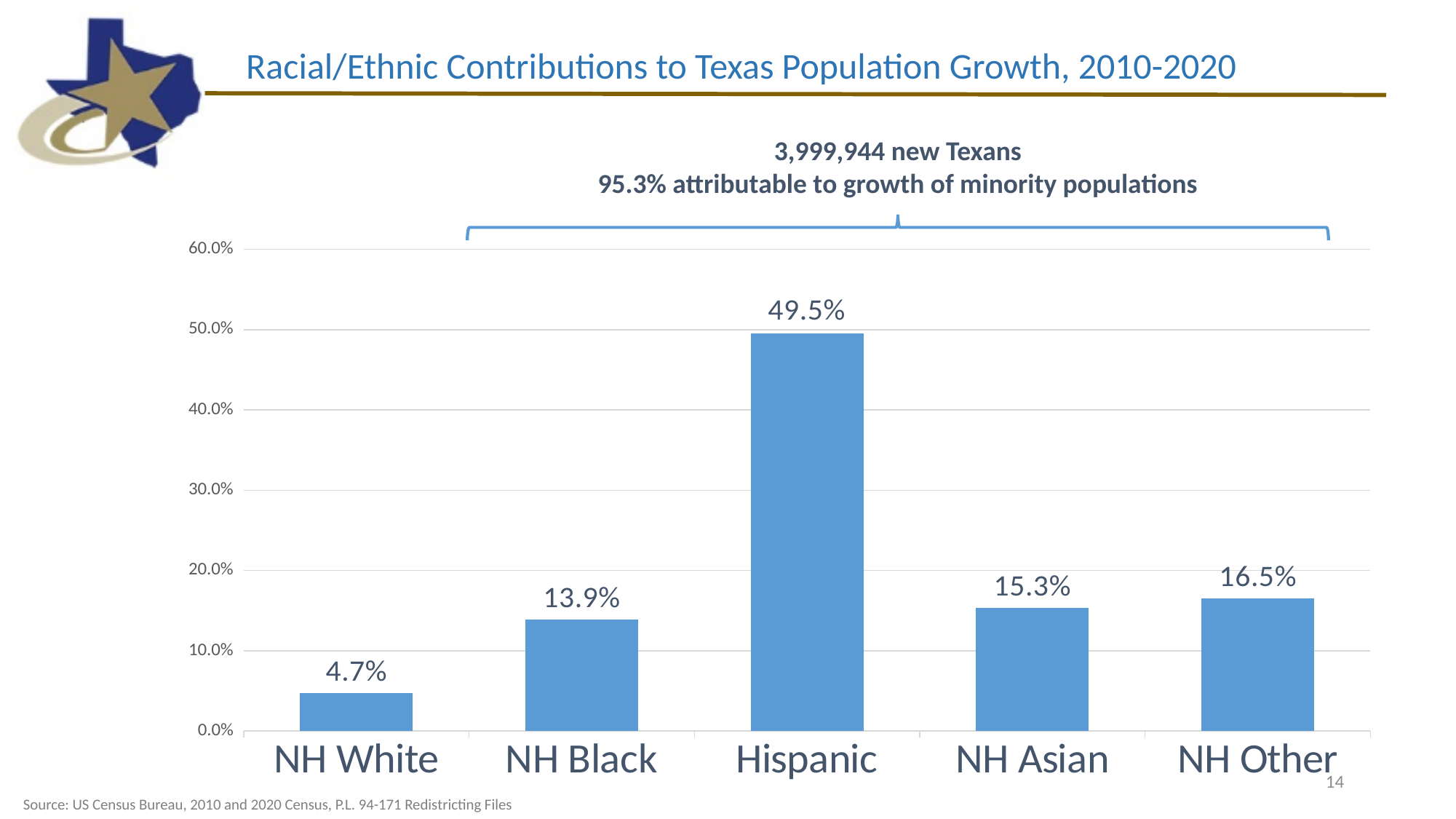
What is the title of the chart? Racial/Ethnic Contributions to Texas Population Growth, 2010-2020 Is the value for Hispanic greater or less than 40.0%? greater How many categories are shown on the x axis? 5 What is the difference between the values for NH Other and NH White? 11.8% What is the difference between the values for Hispanic and NH Black? 35.6% What is the value for NH Asian? 15.3% Which category has the lowest value? NH White What is the value for Hispanic? 49.5% What kind of chart is shown on the slide? bar chart Which is larger, the value for NH Black or the value for NH Other? NH Other Which category has the highest value? Hispanic What is the value for NH White? 4.7%